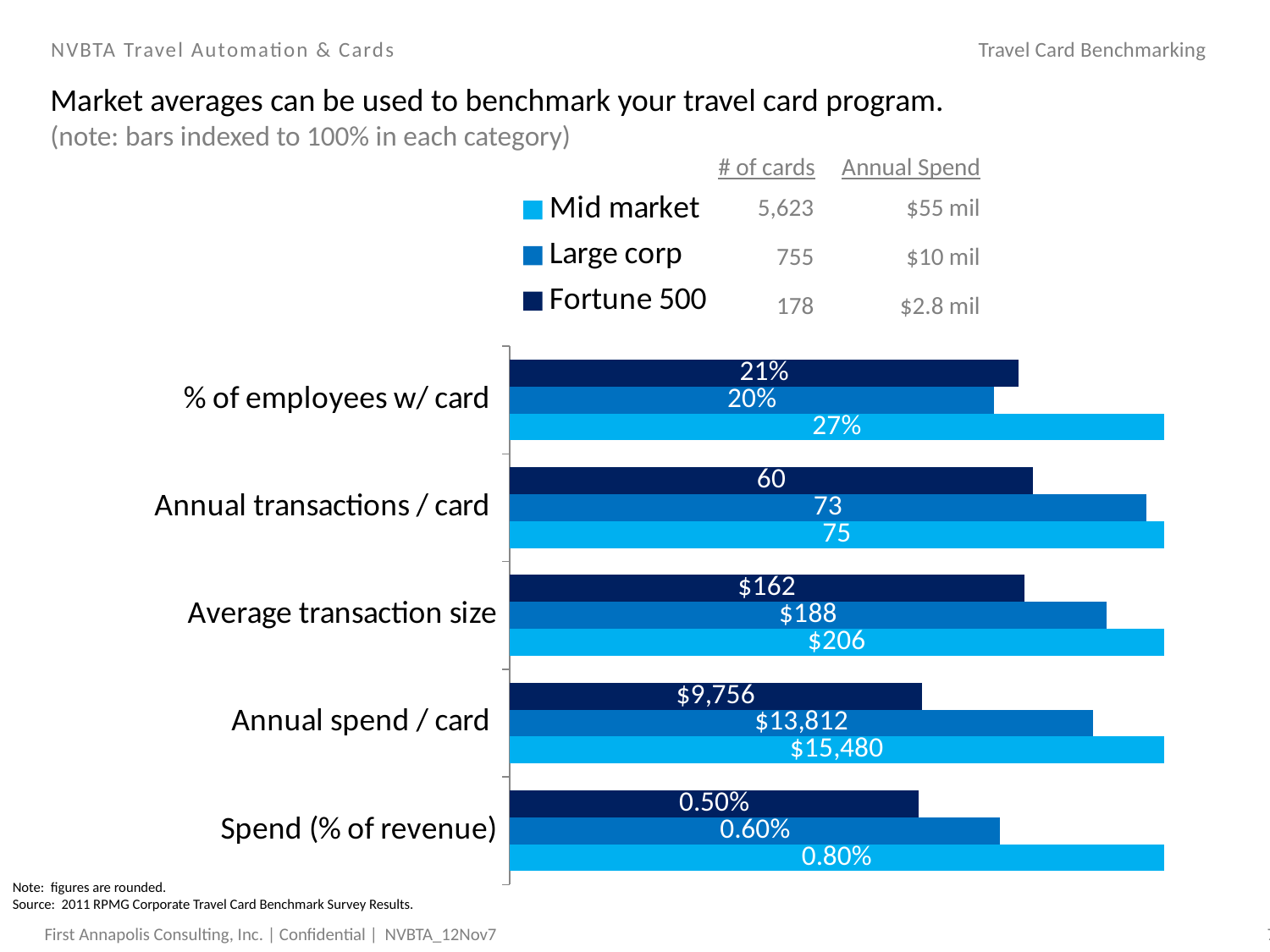
What is the difference between the Large corp and Fortune 500 values for "Annual transactions / card"? 13 What is the value for Large corp in the "Spend (% of revenue)" category? 0.60% Which series has the highest value for "Annual transactions / card"? Mid market What is the value for Mid market in the "% of employees w/ card" category? 27% What kind of chart is shown on the slide? Bar chart Which series has the lowest value for "Average transaction size"? Fortune 500 How many categories are shown on the chart? 5 What is the difference between the Mid market and Fortune 500 values for "Annual spend / card"? $5,724 How many series does the legend list? 3 What is the value for Large corp in the "Average transaction size" category? $188 Which is larger for "% of employees w/ card": Fortune 500 or Large corp? Fortune 500 What is the value for Fortune 500 in the "Annual spend / card" category? $9,756